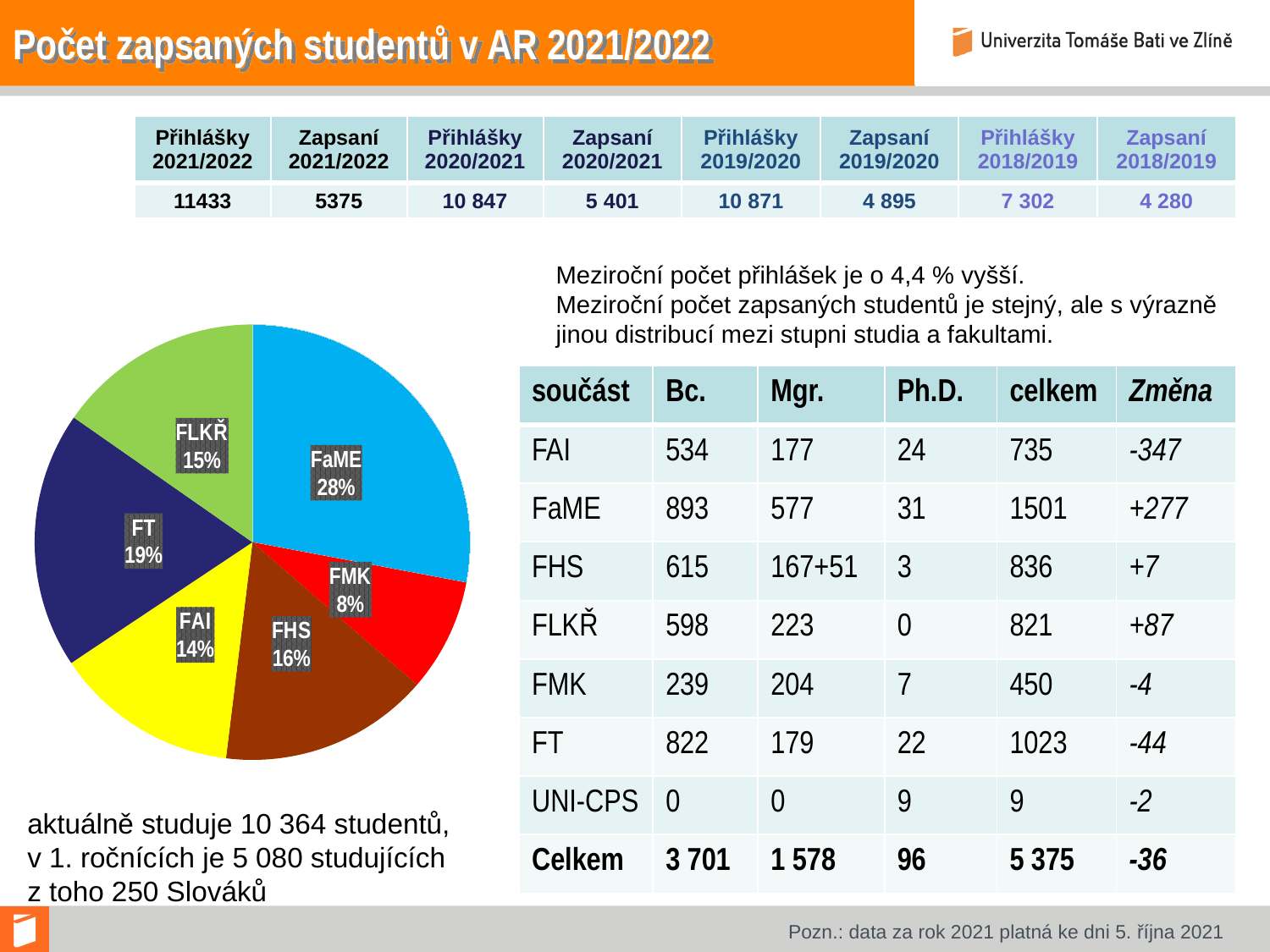
What is the value shown for FLKŘ in the pie chart? 15% By how many percentage points does the FaME slice exceed the FMK slice? 20 What colour is the FaME slice in the pie chart? light blue What is the value shown for FMK in the pie chart? 8% What is the value shown for FT in the pie chart? 19% What type of chart is shown on the slide? pie chart What is the value shown for FHS in the pie chart? 16% Which slice is larger in the pie chart, FT or FAI? FT Which faculty has the largest slice in the pie chart? FaME What share of the pie chart does FaME represent? 28% How many slices does the pie chart have? 6 Which faculty has the smallest slice in the pie chart? FMK